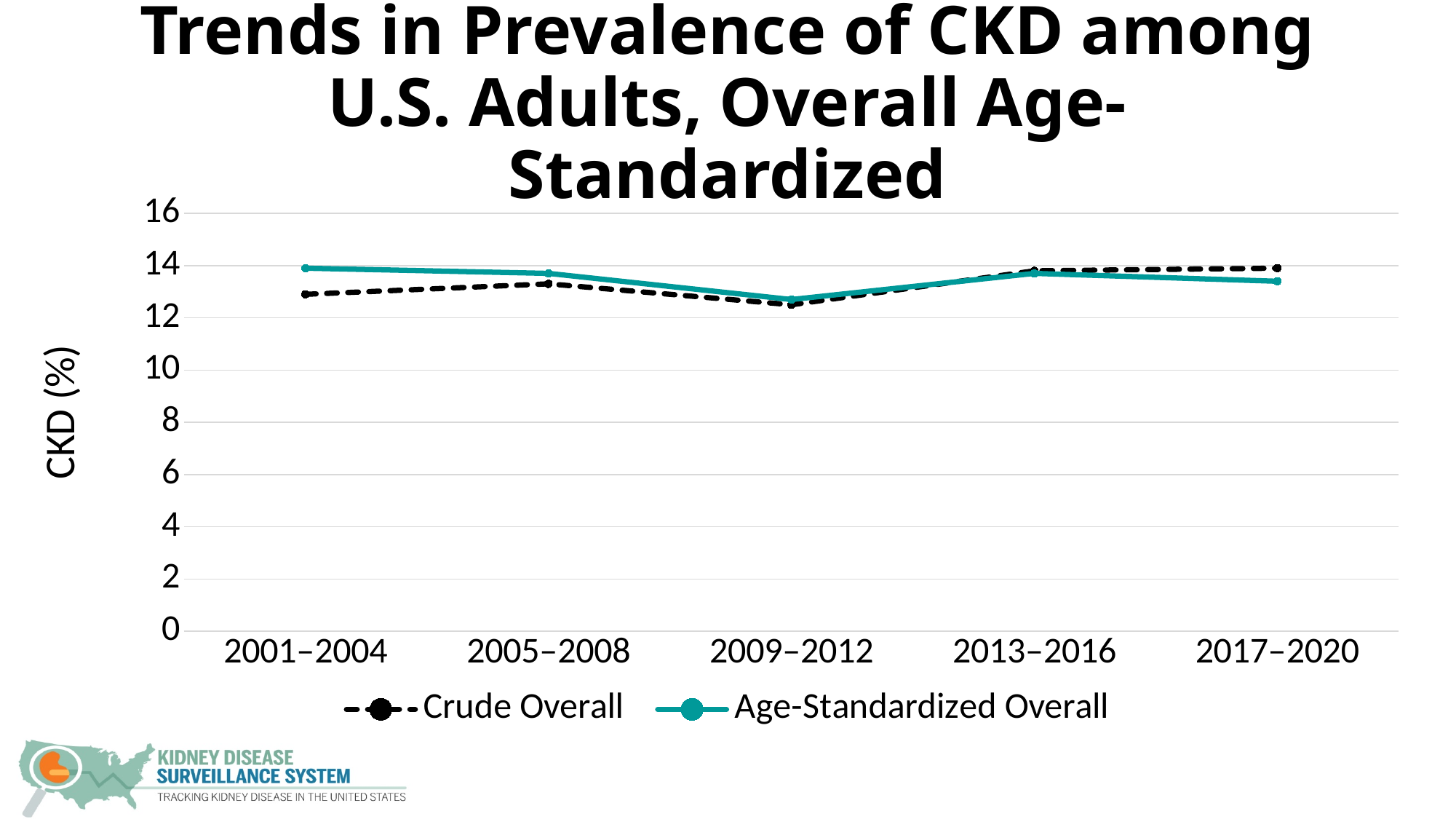
How many series does the legend list? 2 In which period is the Crude Overall value lowest? 2009–2012 How many time periods are shown on the x axis? 5 Is the Crude Overall value for 2001–2004 greater or less than 14? less Does the Age-Standardized Overall line rise or fall from 2001–2004 to 2009–2012? fall What kind of chart is shown on the slide? line chart Is the Age-Standardized Overall value for 2009–2012 greater or less than 14? less Is the Crude Overall value for 2009–2012 greater or less than 12? greater What is the label on the y axis? CKD (%) Which series is drawn with a dashed black line? Crude Overall In 2001–2004, which series has the higher value, Crude Overall or Age-Standardized Overall? Age-Standardized Overall In 2017–2020, which series has the higher value, Crude Overall or Age-Standardized Overall? Crude Overall